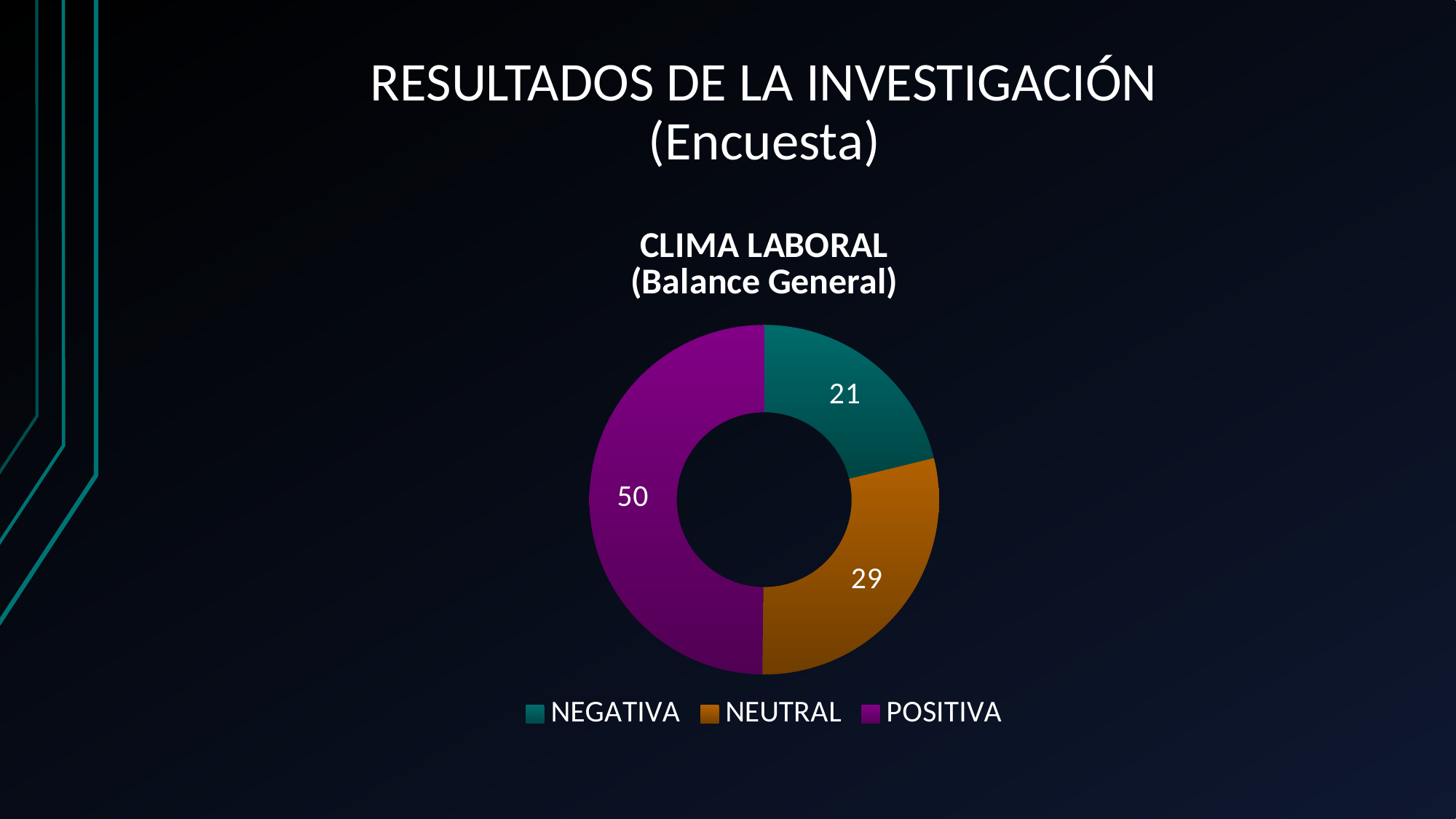
Which category has the smallest value in the CLIMA LABORAL chart? NEGATIVA What is the difference between the NEUTRAL and NEGATIVA values? 8 How many categories does the CLIMA LABORAL chart show? 3 What is the value for NEGATIVA in the CLIMA LABORAL chart? 21 Which is larger, NEUTRAL or NEGATIVA? NEUTRAL What is the value for NEUTRAL in the CLIMA LABORAL chart? 29 What kind of chart is shown on the slide? Doughnut chart Which category has the largest value in the CLIMA LABORAL chart? POSITIVA What is the title of the chart? CLIMA LABORAL (Balance General) What is the difference between the POSITIVA and NEGATIVA values? 29 What share of the total does POSITIVA represent? 50% What is the value for POSITIVA in the CLIMA LABORAL chart? 50